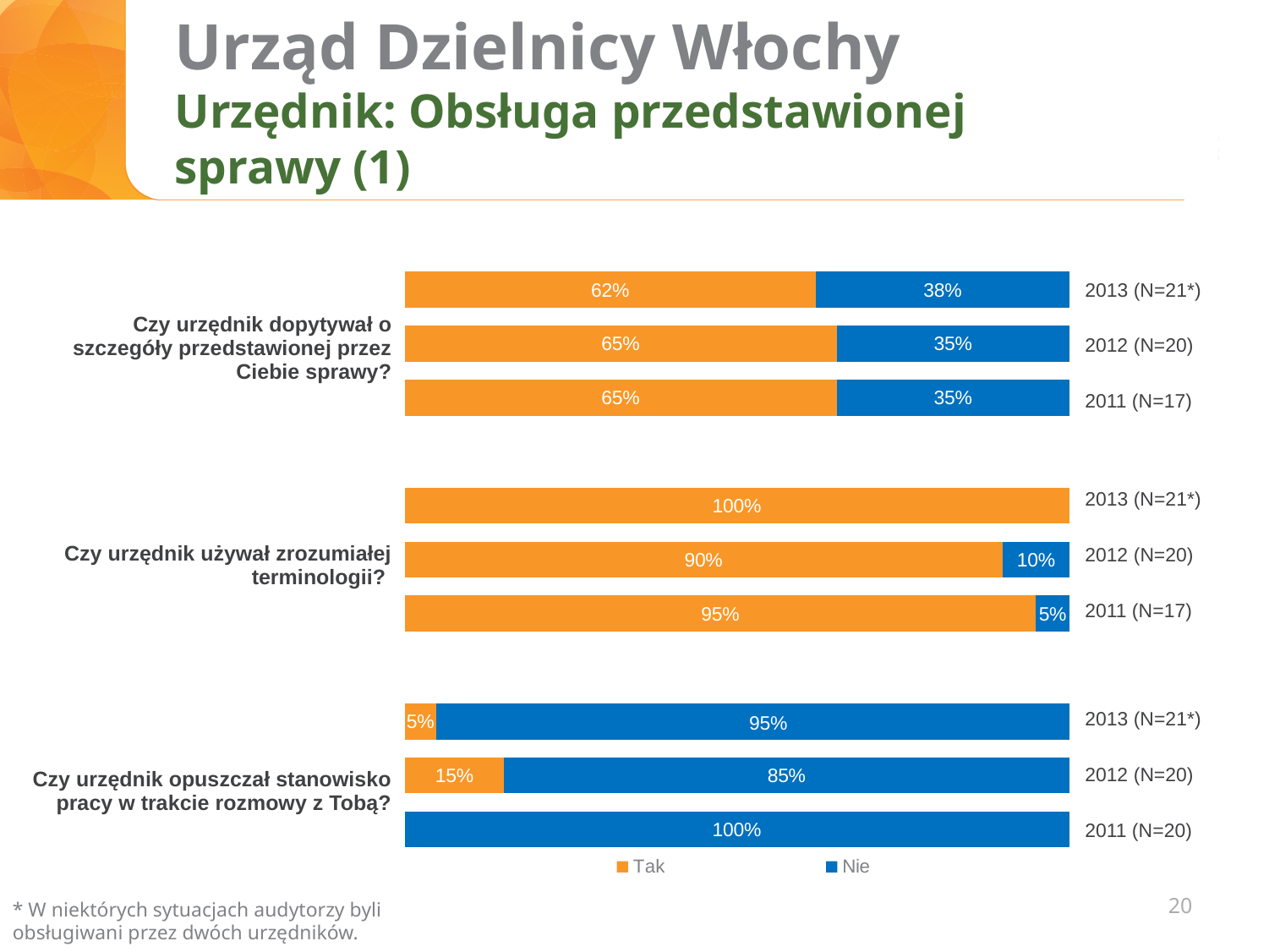
What is the 'Tak' value for 2013 (N=21*) for the question 'Czy urzędnik dopytywał o szczegóły przedstawionej przez Ciebie sprawy?' 62% For the question 'Czy urzędnik opuszczał stanowisko pracy w trakcie rozmowy z Tobą?', which year has the lowest 'Nie' value? 2012 (N=20) What is the 'Nie' value for 2012 (N=20) for the question 'Czy urzędnik używał zrozumiałej terminologii?' 10% For the question 'Czy urzędnik używał zrozumiałej terminologii?', is the 'Nie' value larger in 2012 (N=20) or in 2011 (N=17)? 2012 (N=20) What is the total of the stacked bar for 2011 (N=17) for the question 'Czy urzędnik dopytywał o szczegóły przedstawionej przez Ciebie sprawy?' 100% How many series does the legend list? 2 What kind of chart is shown on the slide? Stacked bar chart What is the difference between the 'Tak' values for 2012 (N=20) and 2013 (N=21*) for the question 'Czy urzędnik dopytywał o szczegóły przedstawionej przez Ciebie sprawy?' 3% What are the two legend entries? Tak and Nie What is the 'Nie' value for 2013 (N=21*) for the question 'Czy urzędnik opuszczał stanowisko pracy w trakcie rozmowy z Tobą?' 95% For the question 'Czy urzędnik używał zrozumiałej terminologii?', which year has the highest 'Tak' value? 2013 (N=21*) How many bars are plotted in the chart in total? 9